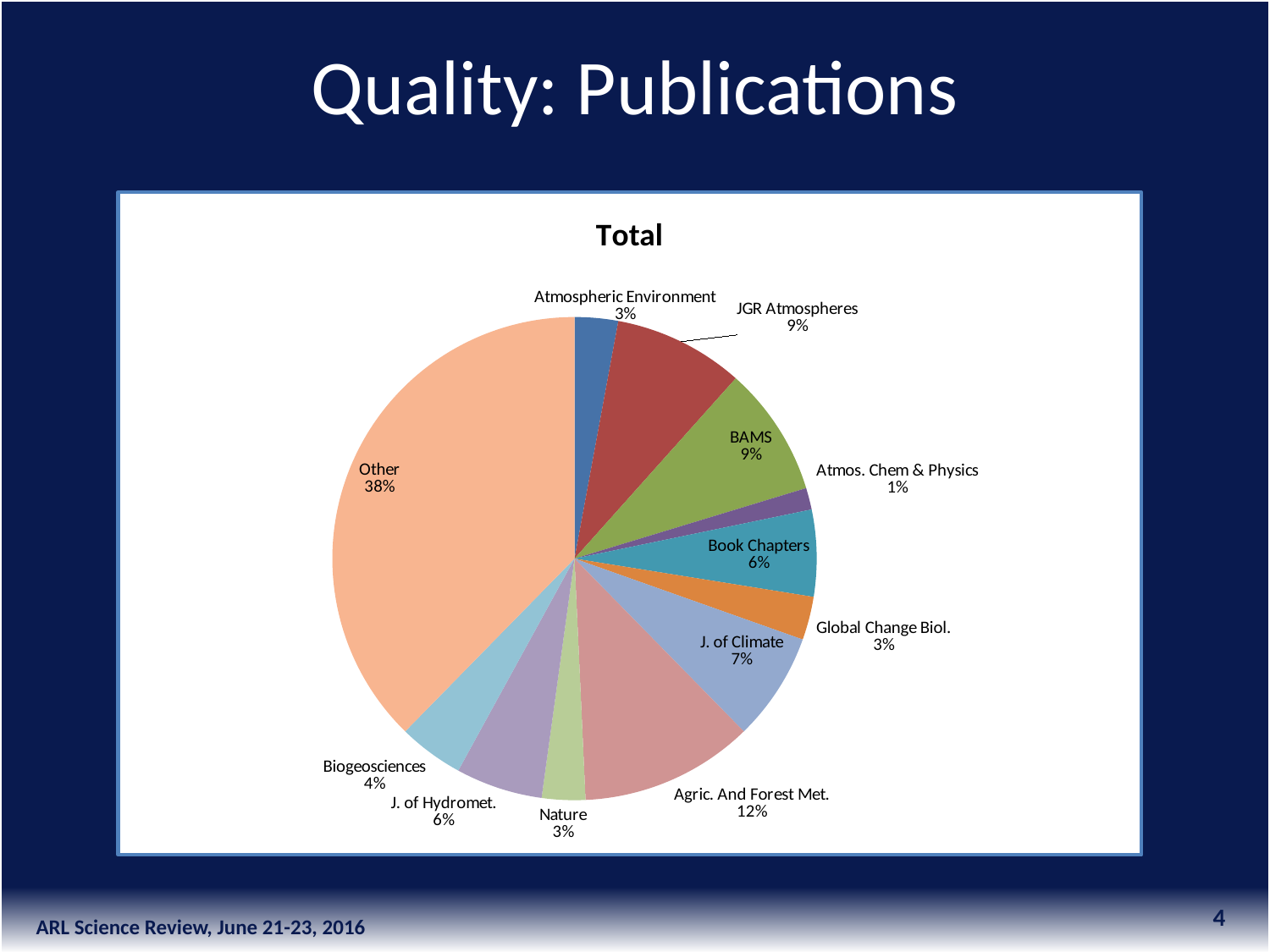
What is the value shown for Book Chapters? 6% What share of the pie does Other represent? 38% Which is larger, the share for J. of Hydromet. or the share for Biogeosciences? J. of Hydromet. Which category has the largest slice of the pie? Other What is the title of the chart? Total Which category has the smallest slice of the pie? Atmos. Chem & Physics What kind of chart is shown on the slide? pie chart How many slices does the pie chart have? 12 What is the value shown for J. of Climate? 7% What is the difference between the shares for Other and Agric. And Forest Met.? 26% What is the combined share of JGR Atmospheres and BAMS? 18% What share of the pie does Agric. And Forest Met. represent? 12%